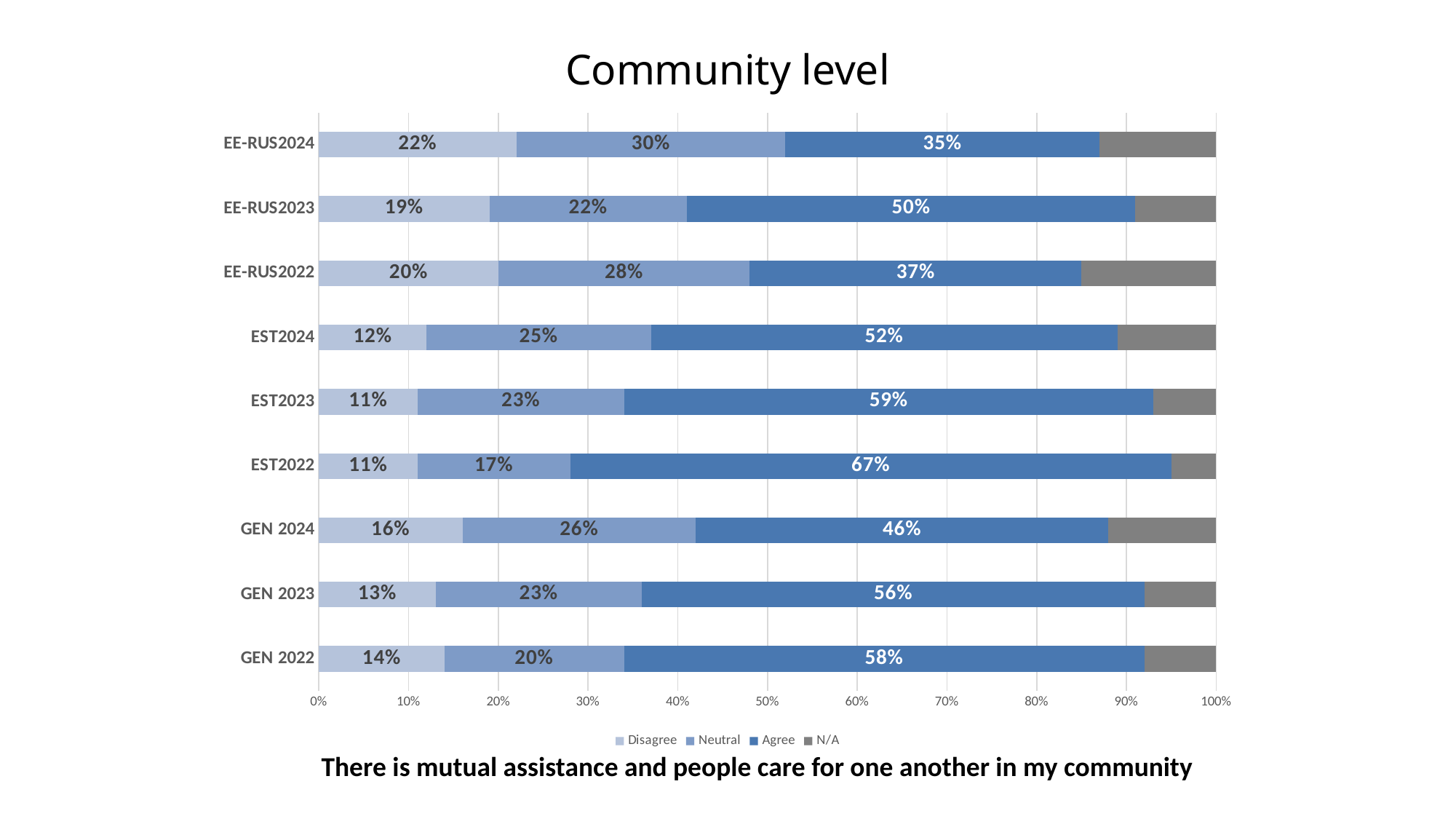
What percentage of EST2022 respondents agree? 67% Is the N/A value for EST2022 greater or less than 10%? less How many percentage points higher is the Agree value for EE-RUS2023 than for EE-RUS2022? 13 percentage points Does the Agree value for EST rise or fall from 2022 to 2024? Fall What kind of chart is shown on the slide? Stacked bar chart Which category has the highest Agree value? EST2022 What is the Neutral value for GEN 2024? 26% What is the Disagree value for EE-RUS2024? 22% Which category has the lowest Agree value? EE-RUS2024 How many categories (bars) are shown on the chart? 9 How many series does the legend list? 4 Which has the larger Neutral value, EE-RUS2024 or EST2024? EE-RUS2024